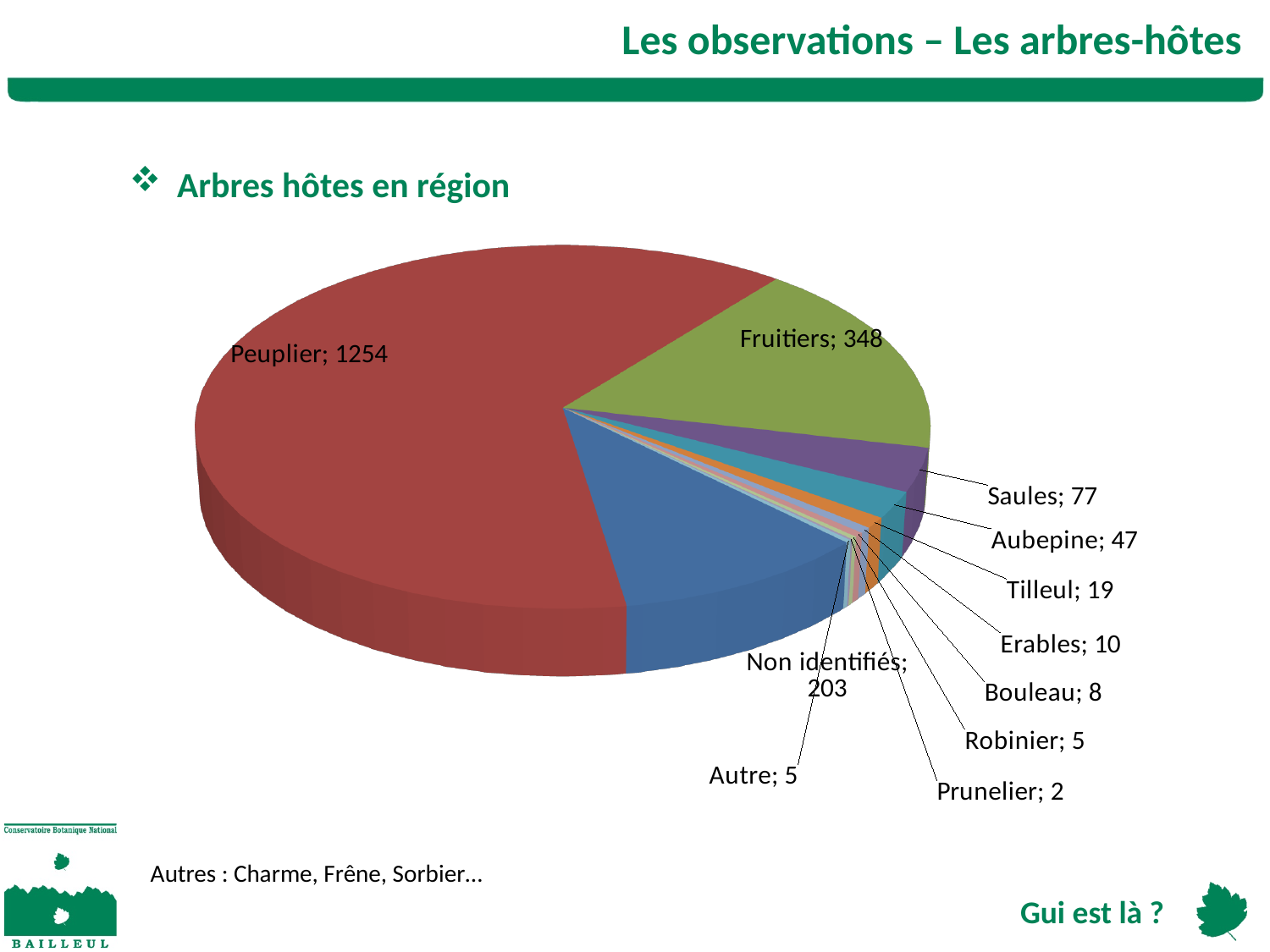
What is the difference between the values for Peuplier and Fruitiers? 906 What is the title of the chart section on the slide? Arbres hôtes en région How many categories are shown in the pie chart? 11 What is the difference between the values for Saules and Aubepine? 30 What kind of chart is shown on the slide? Pie chart What is the value for Non identifiés? 203 Which category has the largest slice? Peuplier Which is larger, the value for Tilleul or the value for Erables? Tilleul Which category has the smallest value? Prunelier What is the value for Aubepine? 47 What is the value for Fruitiers? 348 What is the value for Peuplier? 1254